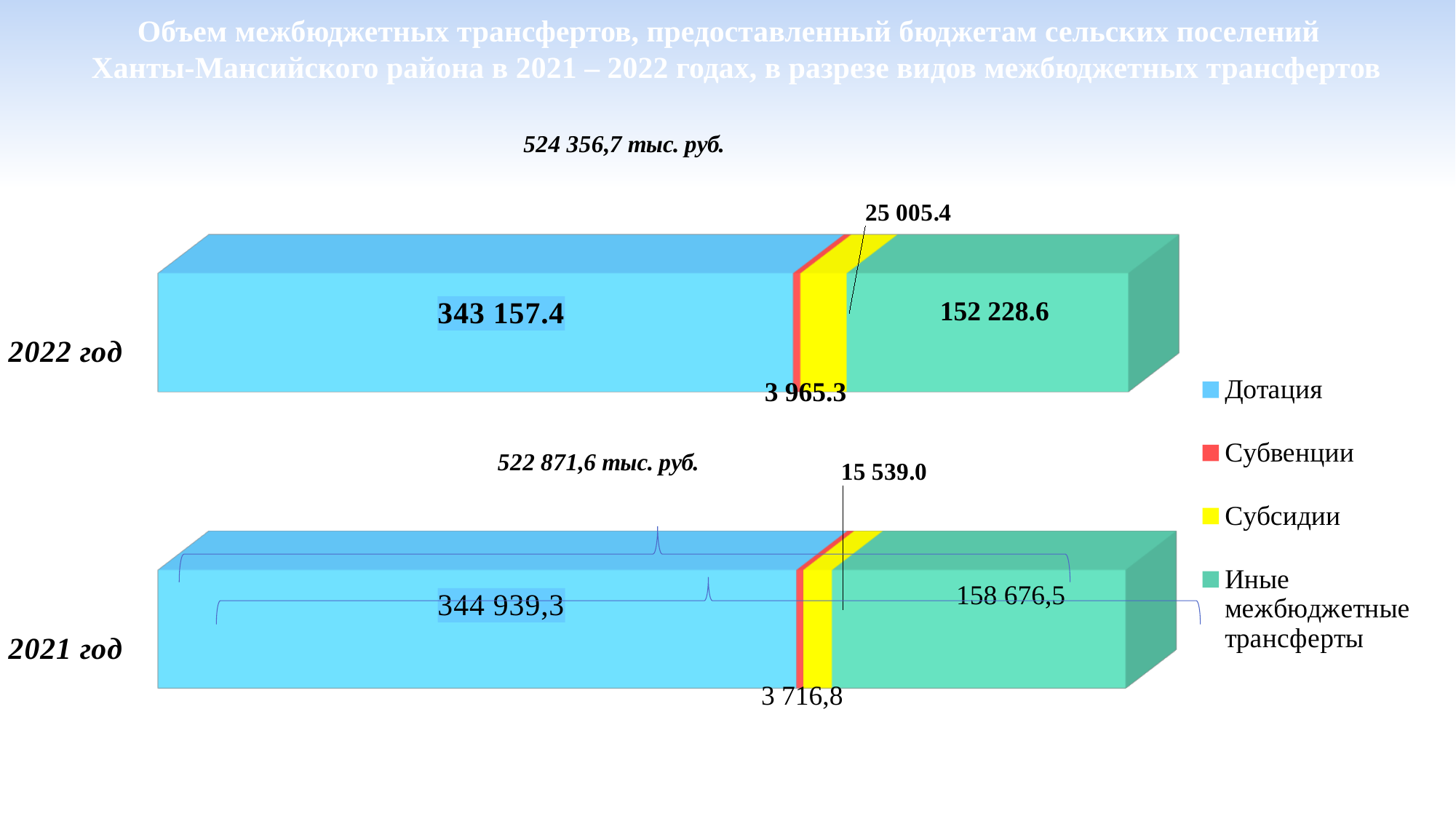
Which is larger: Иные межбюджетные трансферты in 2021 год or in 2022 год? 2021 год What is the total of the 2022 год stacked bar as printed on the slide? 524 356,7 тыс. руб. What is the value of Субвенции for 2021 год? 3 716,8 What is the difference between the Субсидии values for 2022 год and 2021 год? 9 466.4 How many years (bars) are shown in the chart? 2 Which series has the largest value in the 2022 год bar? Дотация How many series does the legend list? 4 What is the value of Субсидии for 2021 год? 15 539.0 What is the value of Иные межбюджетные трансферты for 2022 год? 152 228.6 What kind of chart is shown on the slide? Stacked bar chart Which series has the smallest value in the 2021 год bar? Субвенции What is the value of Дотация for 2022 год? 343 157.4